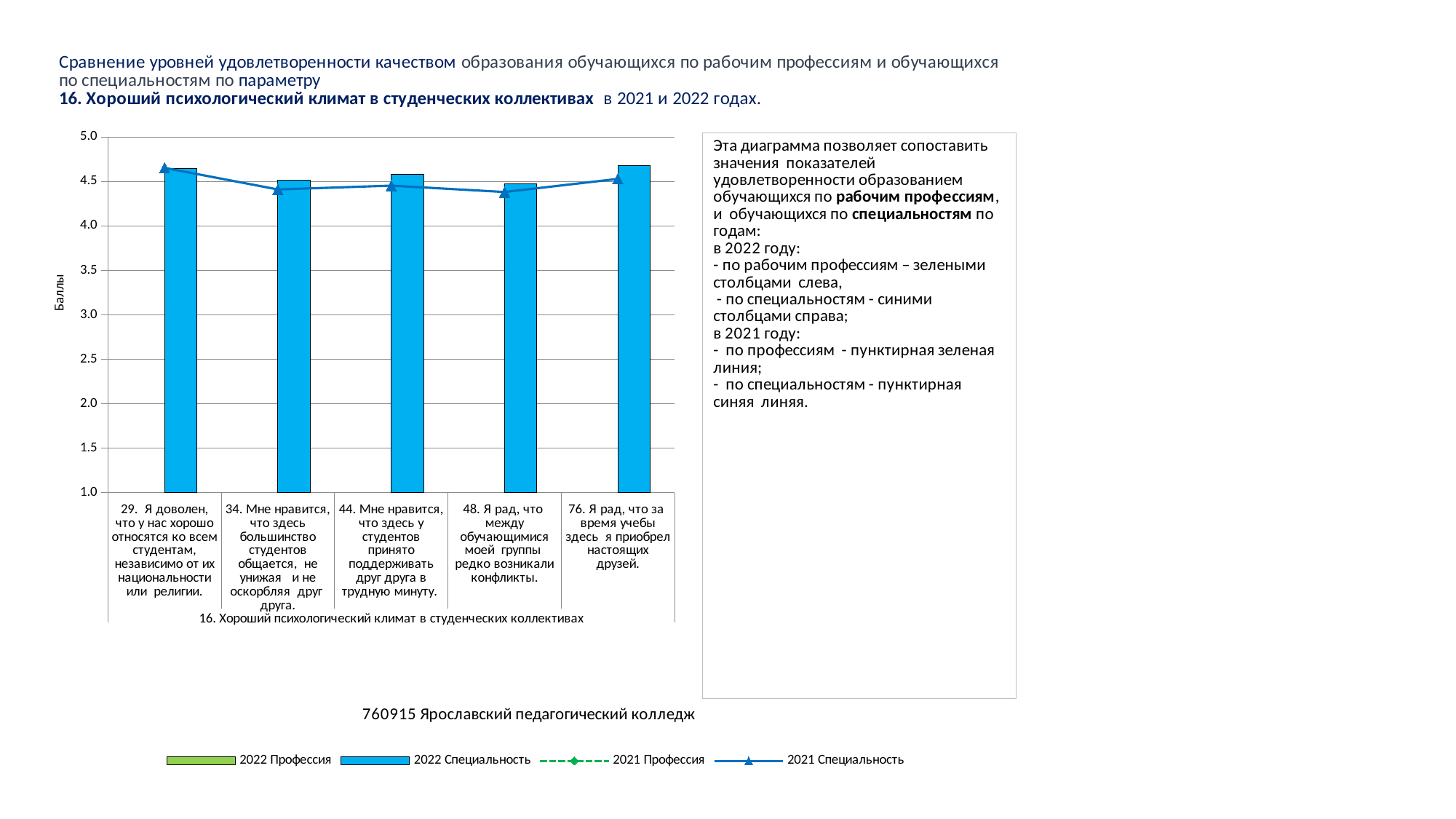
How many categories (questions) are shown on the x axis of the chart? 5 What is the label of the vertical axis? Баллы What is the highest value shown on the vertical axis? 5.0 Is the 2021 Специальность line value for category 29 greater or less than 4.5? greater Which 2022 Специальность bar is taller: category 29 or category 34? 29 Which category has the highest value on the 2021 Специальность line? 29 Is the 2022 Специальность bar for category 34 greater or less than 4.0? greater What kind of chart is shown on the slide? bar chart with a line How many series does the chart legend list? 4 Which 2022 Специальность bar is taller: category 76 or category 48? 76 Is the 2022 Специальность bar for category 76 greater or less than 4.5? greater